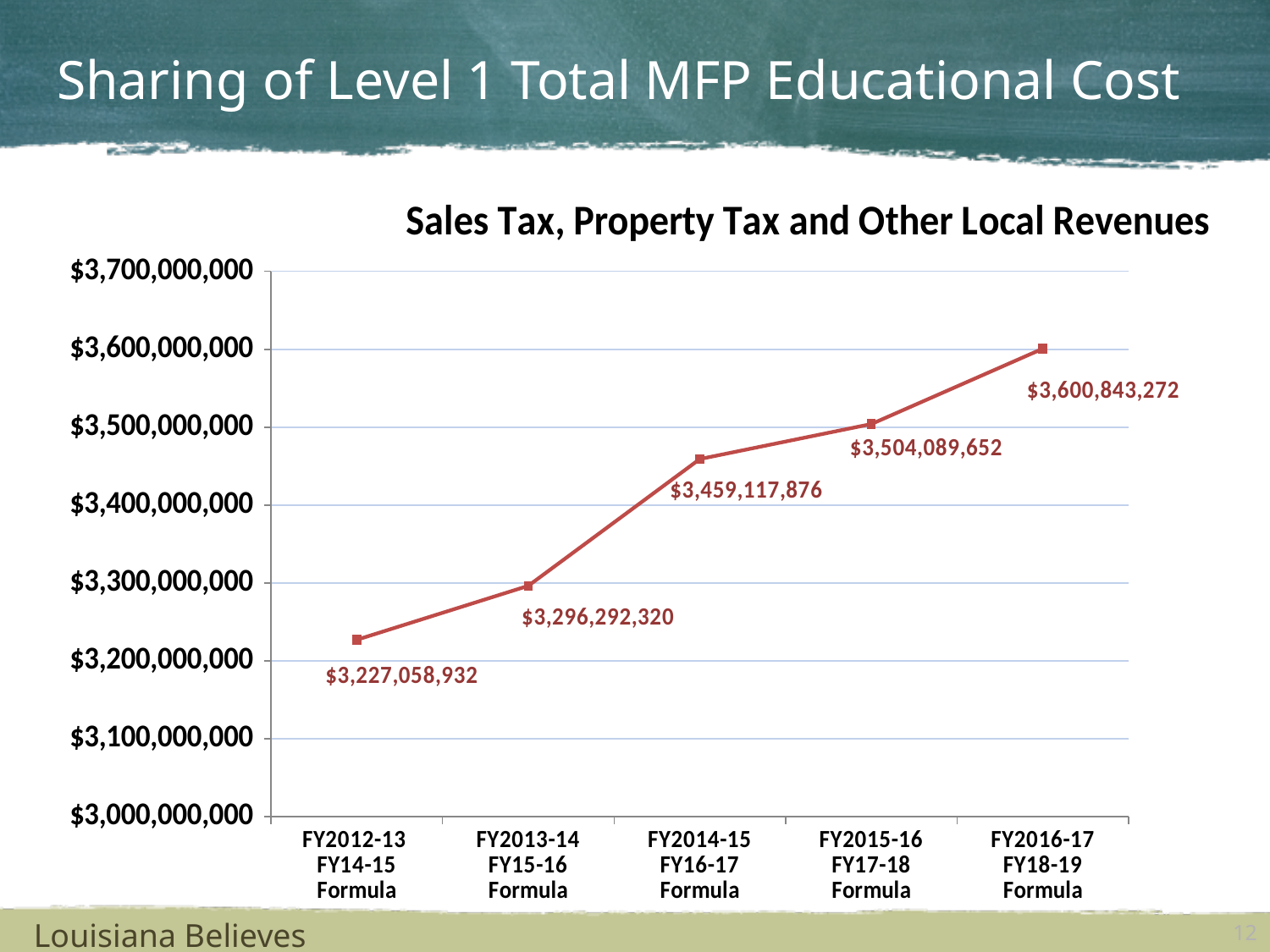
Which fiscal year has the lowest value? FY2012-13 (FY14-15 Formula) What is the value for FY2014-15 (FY16-17 Formula)? $3,459,117,876 Which fiscal year has the highest value? FY2016-17 (FY18-19 Formula) What is the value for FY2016-17 (FY18-19 Formula)? $3,600,843,272 Which is larger, the value for FY2013-14 or the value for FY2015-16? FY2015-16 Is the value for FY2013-14 (FY15-16 Formula) greater or less than $3,300,000,000? less How many fiscal years are plotted on the chart? 5 What is the difference between the FY2014-15 value and the FY2013-14 value? $162,825,556 What is the value for FY2012-13 (FY14-15 Formula)? $3,227,058,932 Do the values rise or fall from FY2012-13 to FY2016-17? rise What is the difference between the FY2016-17 value and the FY2015-16 value? $96,753,620 What kind of chart is shown on the slide? line chart